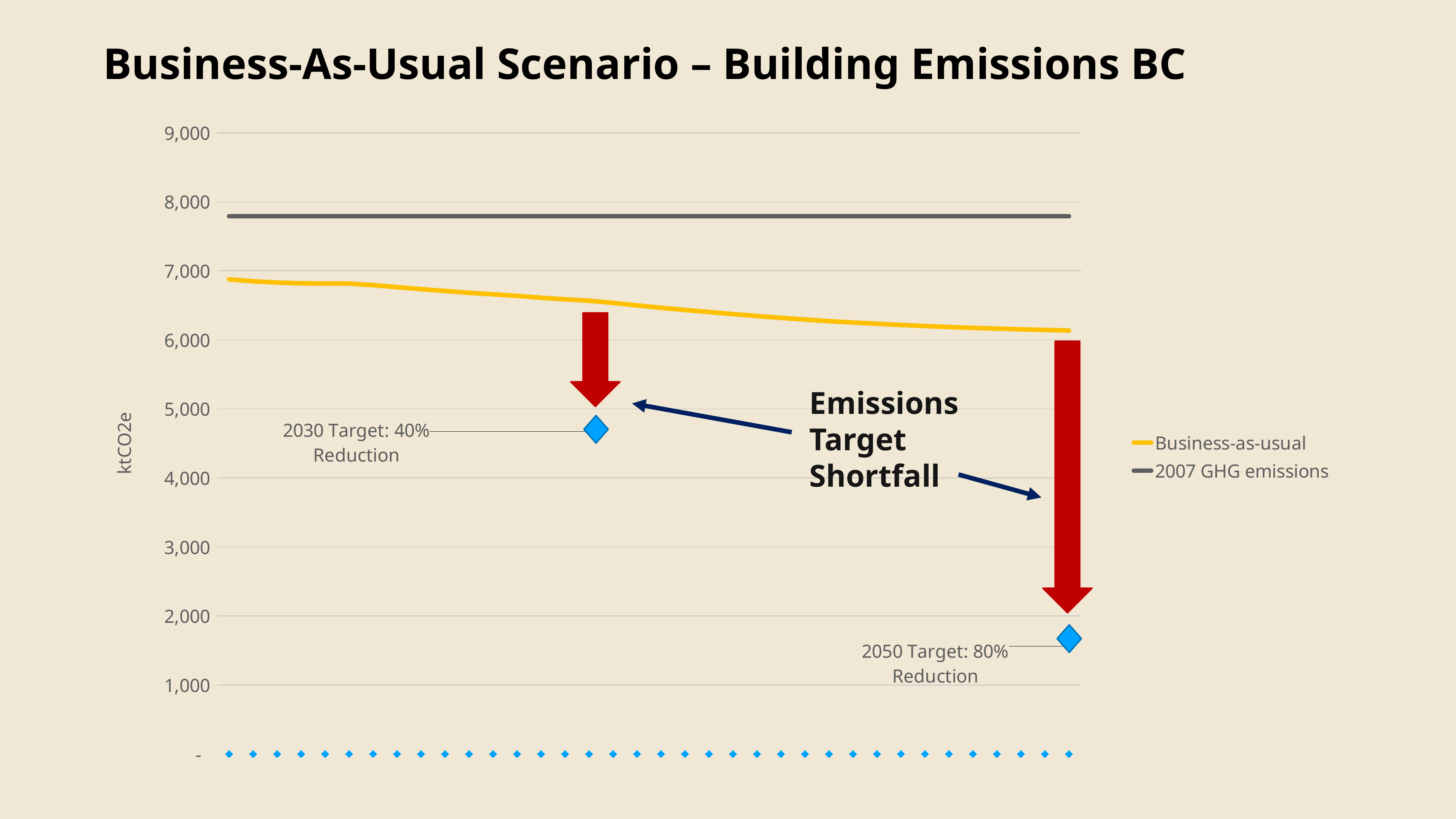
What unit is shown on the vertical axis? ktCO2e Which series is higher across the chart, Business-as-usual or 2007 GHG emissions? 2007 GHG emissions Is the 2030 Target: 40% Reduction marker greater or less than 5,000? less Is the 2050 Target: 80% Reduction marker greater or less than 2,000? less Is the value of the 2007 GHG emissions line greater or less than 8,000? less Does the Business-as-usual line rise or fall from left to right? fall How many series does the legend list? 2 What kind of chart is shown on the slide? line chart What is the title of the chart on the slide? Business-As-Usual Scenario – Building Emissions BC